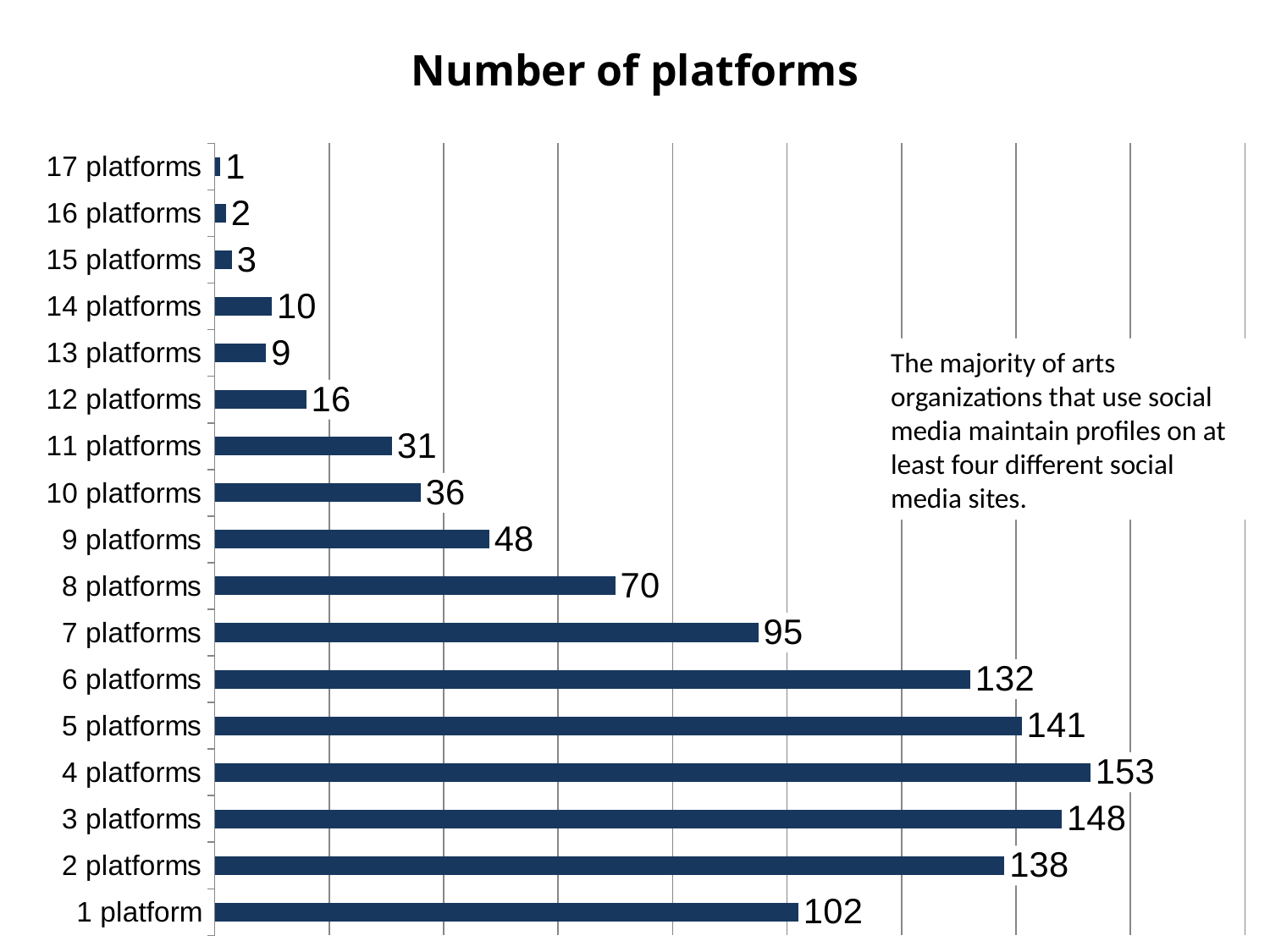
What is the title of the chart? Number of platforms Which is larger, the value for 13 platforms or the value for 14 platforms? 14 platforms What is the difference between the values for 6 platforms and 7 platforms? 37 What is the difference between the values for 3 platforms and 2 platforms? 10 What is the value for 1 platform? 102 Which category has the highest value? 4 platforms What kind of chart is shown on the slide? Bar chart Which category has the lowest value? 17 platforms Which is larger, the value for 5 platforms or the value for 2 platforms? 5 platforms How many categories are shown in the chart? 17 What is the value for 4 platforms? 153 What is the value for 11 platforms? 31